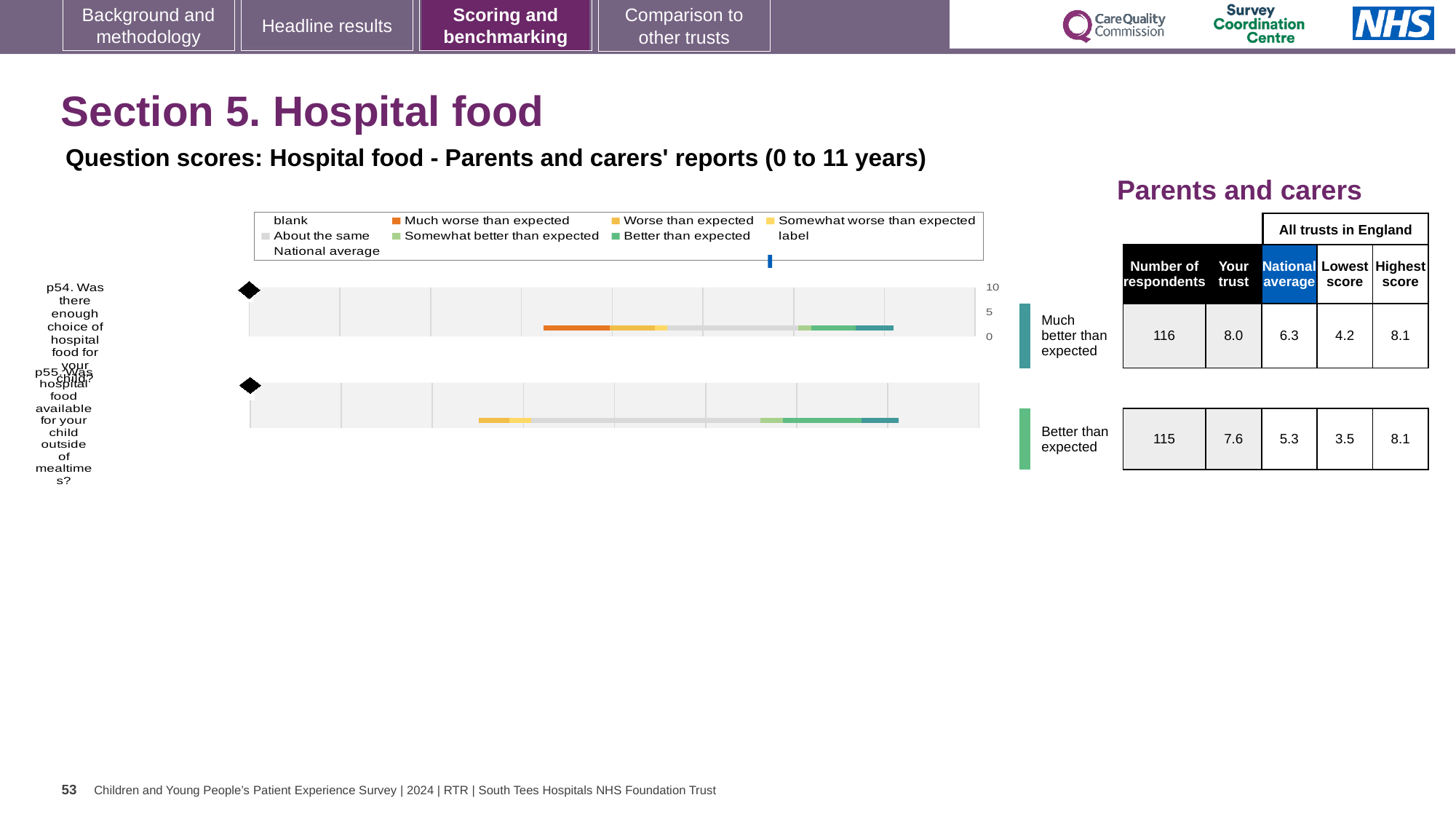
What is the national average score for p55 (hospital food available outside of mealtimes)? 5.3 By how much does the trust's score for p54 exceed the national average for p54? 1.7 Which benchmark category is the trust's result for p54 placed in? Much better than expected How many respondents answered p54? 116 What is the lowest score across all trusts in England for p55? 3.5 What is the difference between the highest and lowest scores for p55? 4.6 What kind of chart is used to show the question scores for hospital food? Bar chart What is the highest score across all trusts in England for p54? 8.1 What colour represents 'Much worse than expected' in the chart legend? Orange How many questions (categories) are plotted in the hospital food chart? 2 Which question has the higher 'Your trust' score, p54 or p55? p54 What is the 'Your trust' score for p54 (enough choice of hospital food for your child)? 8.0